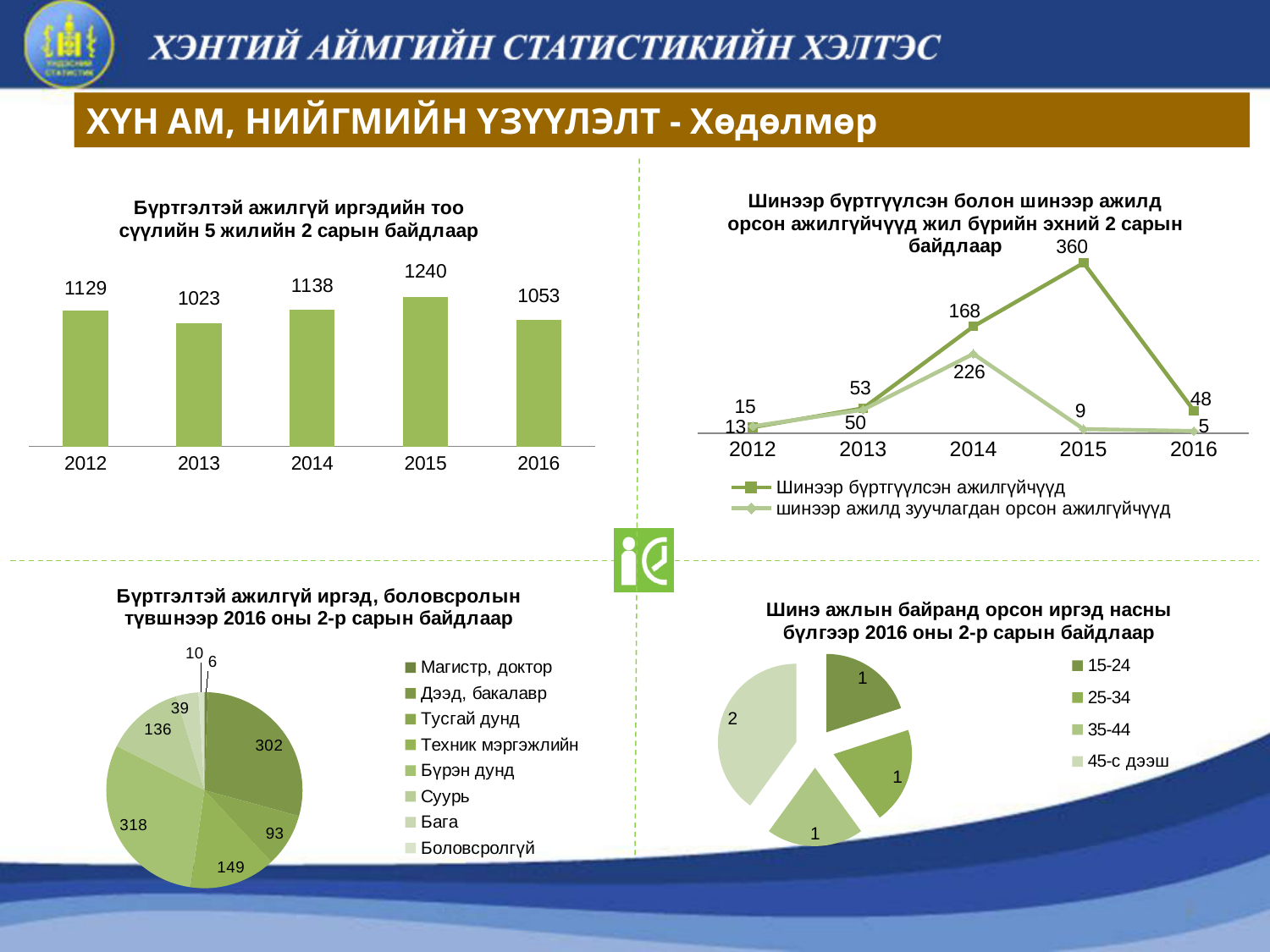
In the pie chart 'Шинэ ажлын байранд орсон иргэд насны бүлгээр', what is the value for '45-с дээш'? 2 In the pie chart 'Бүртгэлтэй ажилгүй иргэд, боловсролын түвшнээр', how many categories does the legend list? 8 In the pie chart 'Бүртгэлтэй ажилгүй иргэд, боловсролын түвшнээр', what is the value for 'Бүрэн дунд'? 318 In the line chart at the top right, which is larger in 2015: 'Шинээр бүртгүүлсэн ажилгүйчүүд' or 'шинээр ажилд зуучлагдан орсон ажилгүйчүүд'? Шинээр бүртгүүлсэн ажилгүйчүүд What type of chart is the top-left chart 'Бүртгэлтэй ажилгүй иргэдийн тоо'? bar chart In the bar chart 'Бүртгэлтэй ажилгүй иргэдийн тоо', which year has the lowest value? 2013 In the bar chart 'Бүртгэлтэй ажилгүй иргэдийн тоо', what is the value for 2015? 1240 In the line chart at the top right, what is the value of 'шинээр ажилд зуучлагдан орсон ажилгүйчүүд' in 2016? 5 In the bar chart 'Бүртгэлтэй ажилгүй иргэдийн тоо', how many years are shown? 5 In the line chart at the top right, what is the value of 'Шинээр бүртгүүлсэн ажилгүйчүүд' in 2015? 360 In the bar chart 'Бүртгэлтэй ажилгүй иргэдийн тоо', what is the difference between the 2015 and 2016 values? 187 In the line chart at the top right, how many series does the legend list? 2